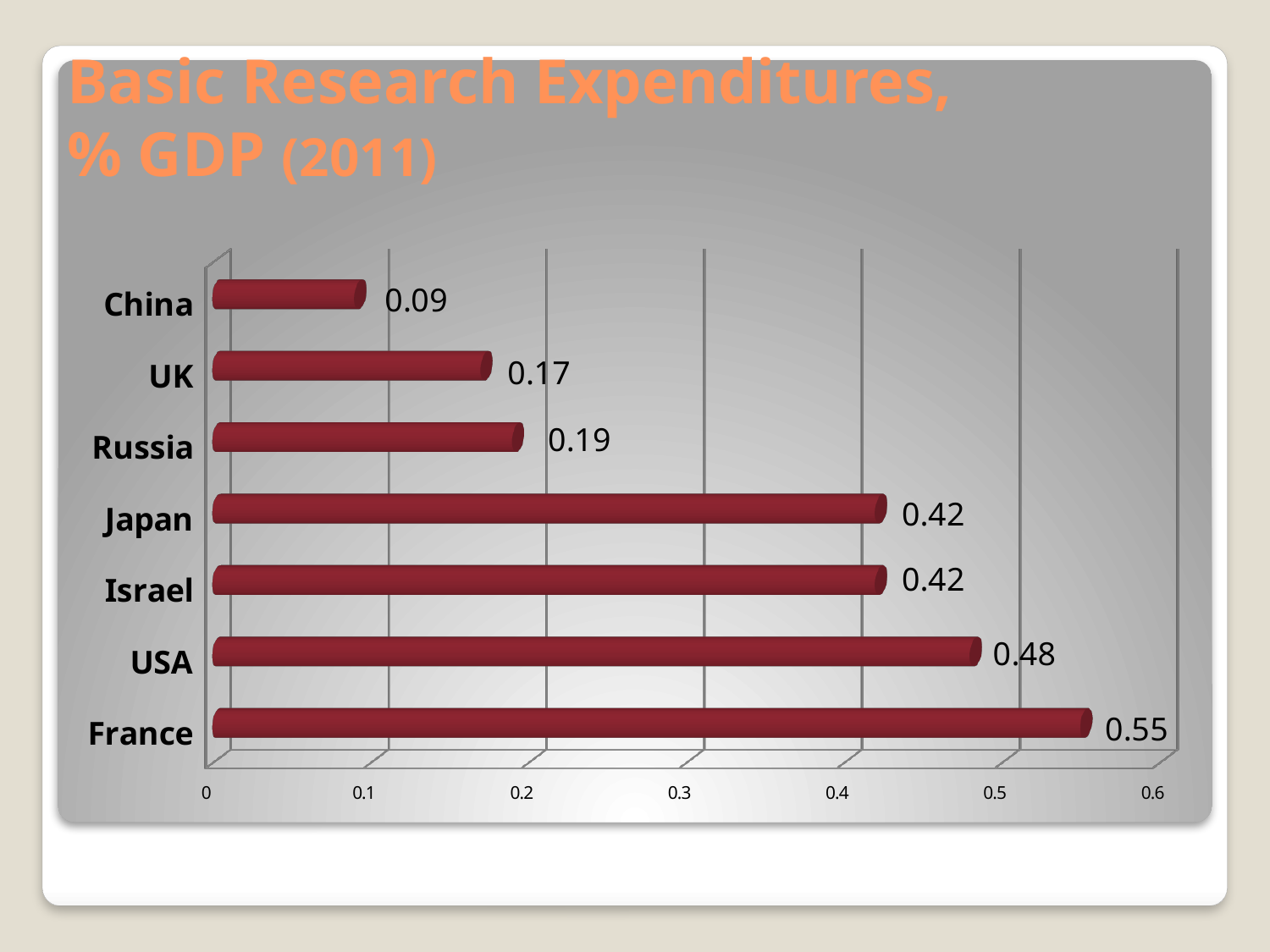
Which is larger, the value for USA or the value for Japan? USA What kind of chart is shown on the slide? bar chart Is the value for Israel greater or less than 0.3? greater Which country has the highest value? France How many countries are shown in the chart? 7 Which country has the lowest value? China What is the value for Russia? 0.19 What is the title of the chart? Basic Research Expenditures, % GDP (2011) What is the difference between the values for France and USA? 0.07 What is the value for China? 0.09 What is the difference between the values for Russia and UK? 0.02 What is the value for France? 0.55